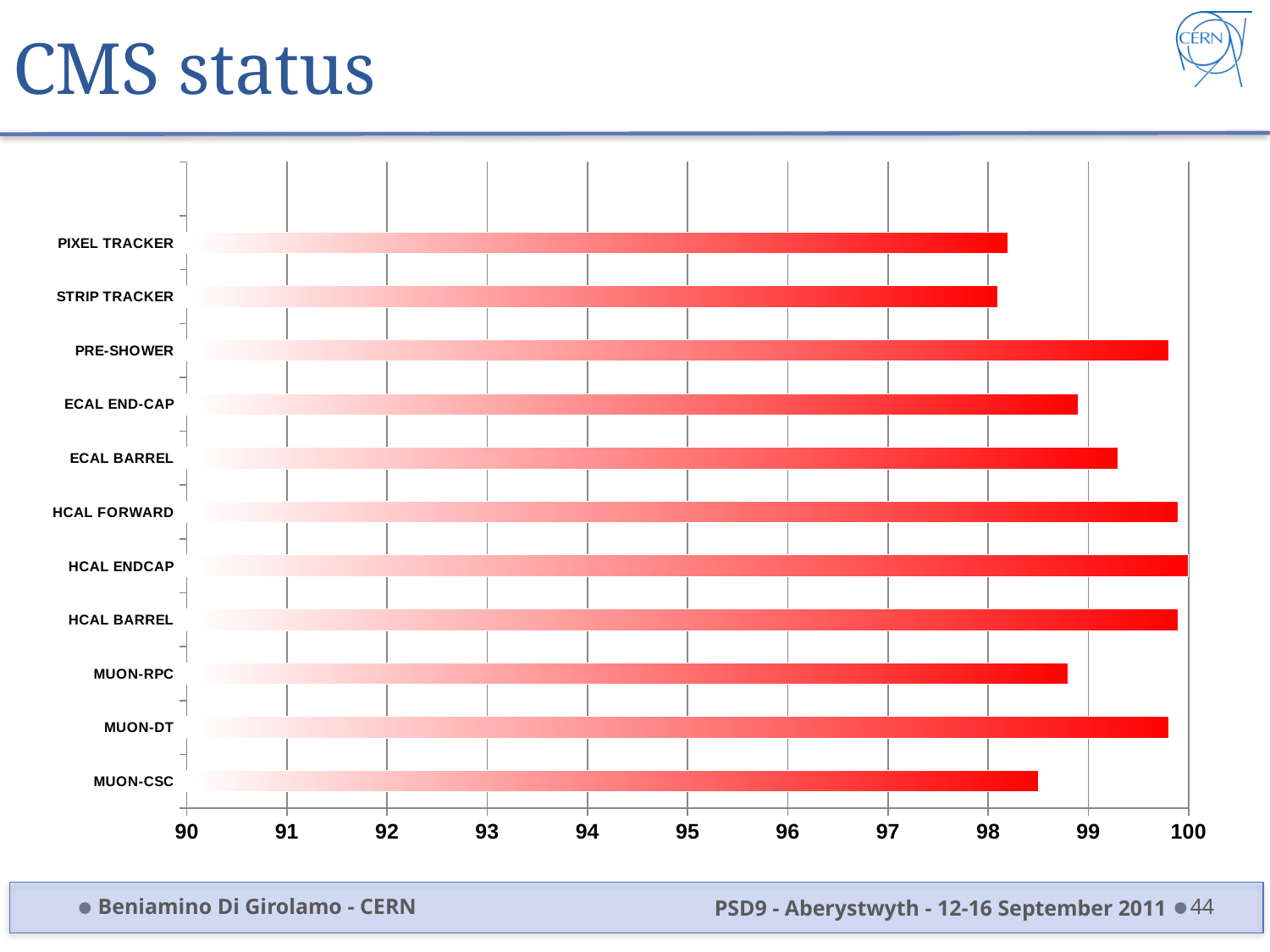
Which has the larger value, HCAL FORWARD or MUON-RPC? HCAL FORWARD Is the value for MUON-CSC greater or less than 98? greater What are the minimum and maximum values shown on the horizontal axis? 90 and 100 Is the value for MUON-RPC greater or less than 99? less Is the value for MUON-CSC greater or less than 99? less How many detector categories are plotted in the chart? 11 What kind of chart is shown on the slide? bar chart Which has the larger value, PRE-SHOWER or MUON-CSC? PRE-SHOWER Which has the larger value, ECAL BARREL or ECAL END-CAP? ECAL BARREL